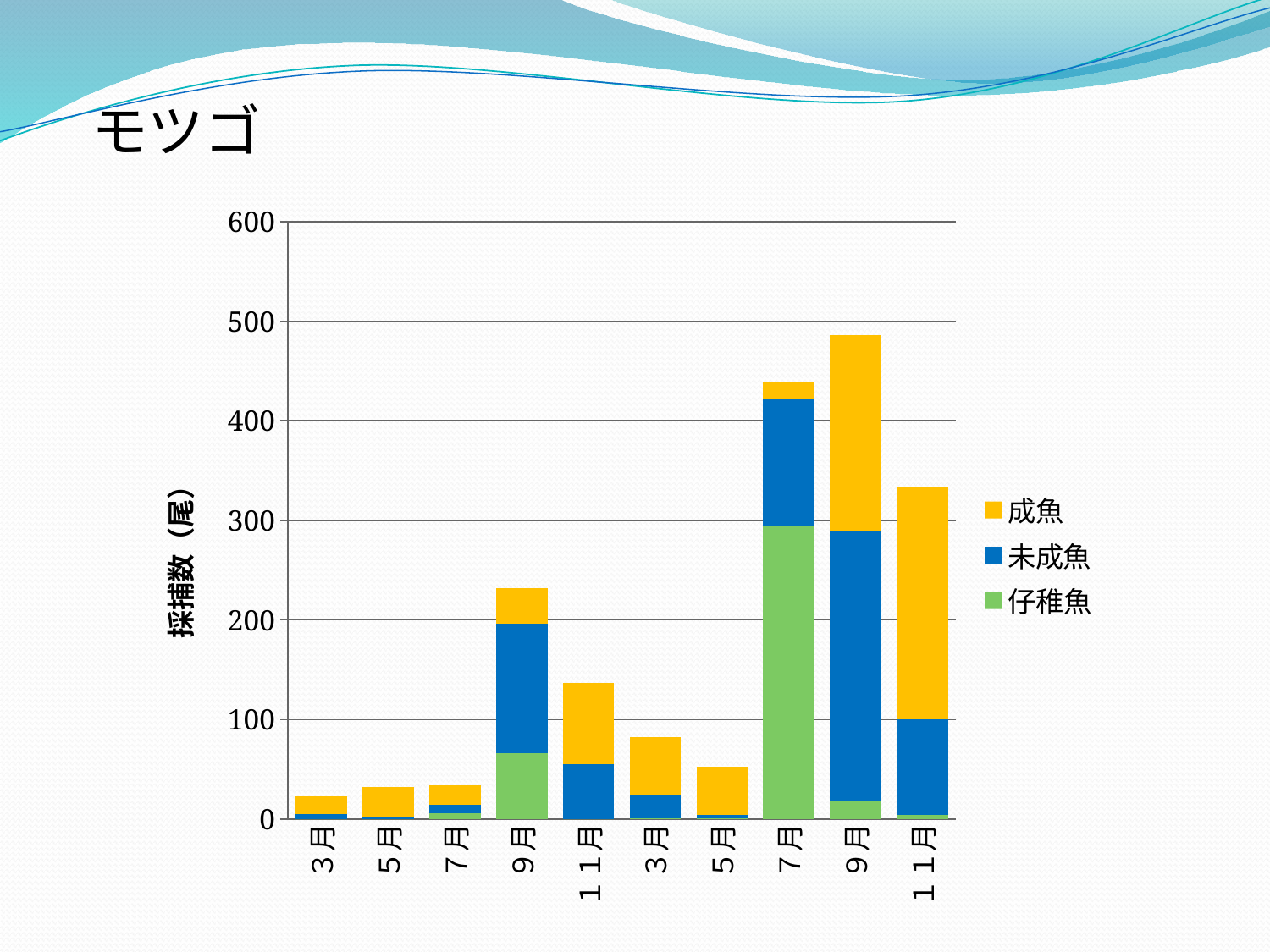
Which bar has the lowest total? The first 3月 (first bar) Is the total for the second 9月 bar greater or less than 400? greater What kind of chart is shown on the slide? Stacked bar chart Which has the larger total, the second 7月 bar or the second 9月 bar? The second 9月 bar How many bars (categories) are plotted along the x axis? 10 How many series does the legend list? 3 Which bar has the highest total? The second 9月 (ninth bar) Is the total for the second 3月 bar (sixth bar) greater or less than 100? less Is the total for the first 11月 bar (fifth bar) greater or less than 200? less Which series is shown in green in the legend? 仔稚魚 What is the label of the y axis? 採捕数（尾）